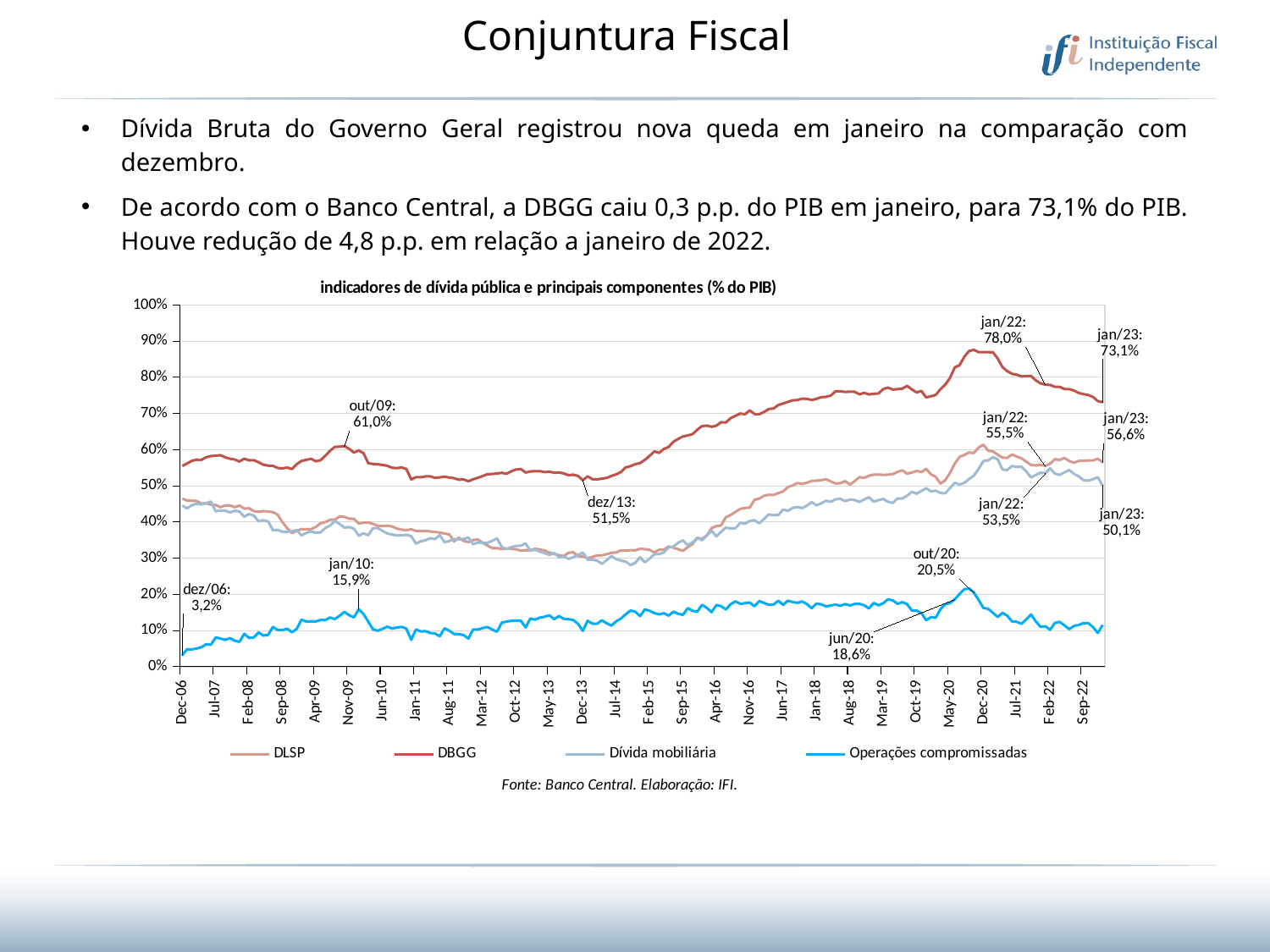
What kind of chart is shown on the slide? line chart What is the value of Operações compromissadas labelled for dez/06? 3,2% What is the DBGG value labelled for out/09? 61,0% What is the Dívida mobiliária value labelled for jan/23? 50,1% How many series does the chart legend list? 4 What is the DBGG value labelled for jan/23? 73,1% What is the DBGG value labelled for jan/22? 78,0% What is the difference between the DBGG values labelled for out/09 (61,0%) and dez/13 (51,5%)? 9,5 p.p. What is the DLSP value labelled for jan/23? 56,6% In jan/23, which is larger: DLSP or Dívida mobiliária? DLSP Is the value of Operações compromissadas at Sep-22 greater or less than 20%? less What is the value of Operações compromissadas labelled for out/20? 20,5%